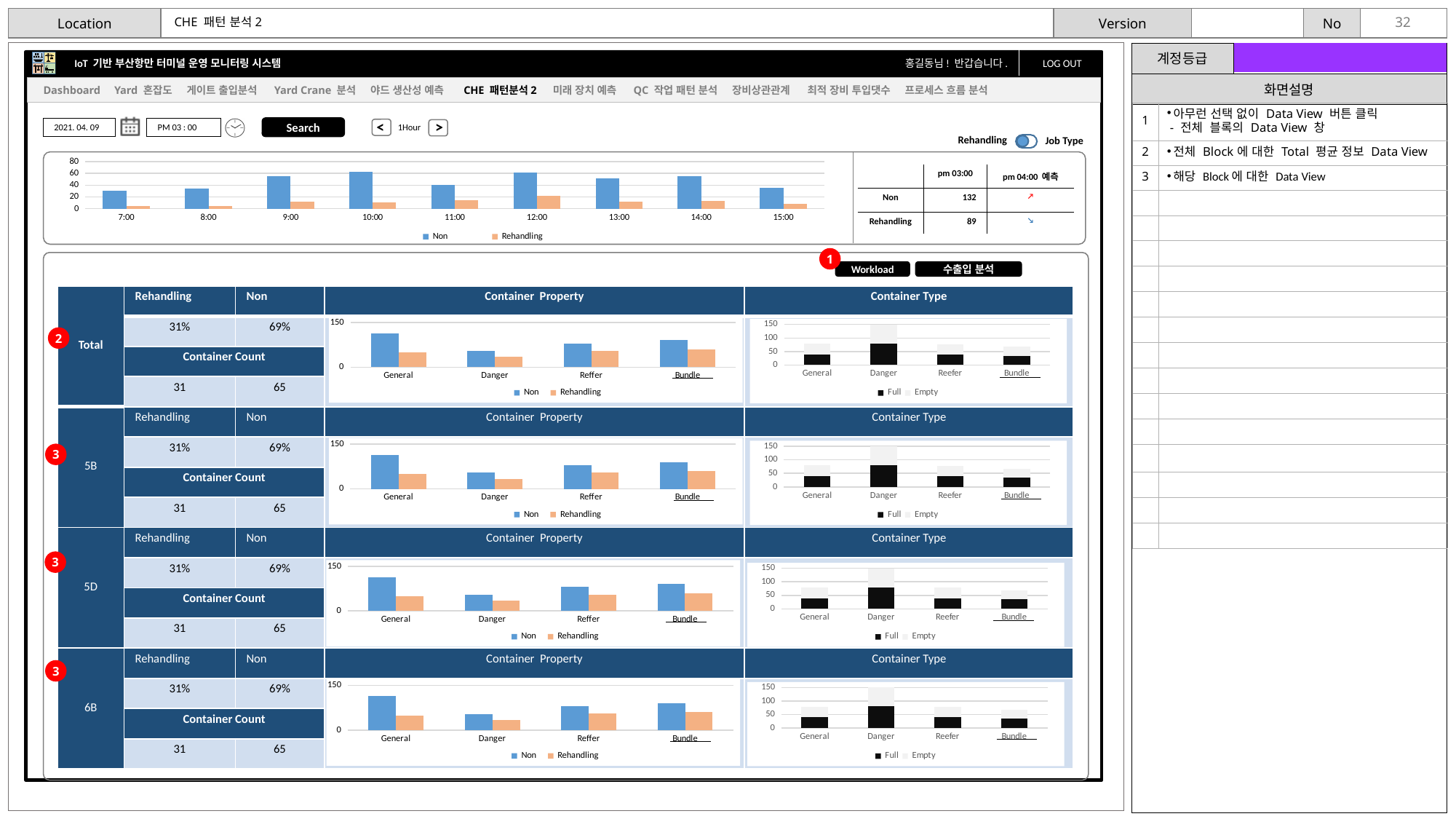
In the top hourly chart, at which time is the Rehandling value highest? 12:00 In the Total row's Container Property chart, which category has the lowest Rehandling value? Danger What kind of chart is the hourly chart at the top of the slide? bar chart In the Total row's Container Type chart, is the Empty value for Danger greater or less than 100? less How many categories are shown on the x axis of the Total row's Container Property chart? 4 What are the two legend entries of the Total row's Container Type chart? Full, Empty In the top hourly chart, is the Non value at 10:00 greater or less than 40? greater In the Total row's Container Property chart, which category has the highest Non value? General In the top hourly chart, which is larger: the Non value at 9:00 or the Non value at 11:00? 9:00 How many series does the legend of the top hourly chart list? 2 In the Total row's Container Type chart, which category has the highest Full value? Danger How many time points are shown on the x axis of the top hourly chart? 9